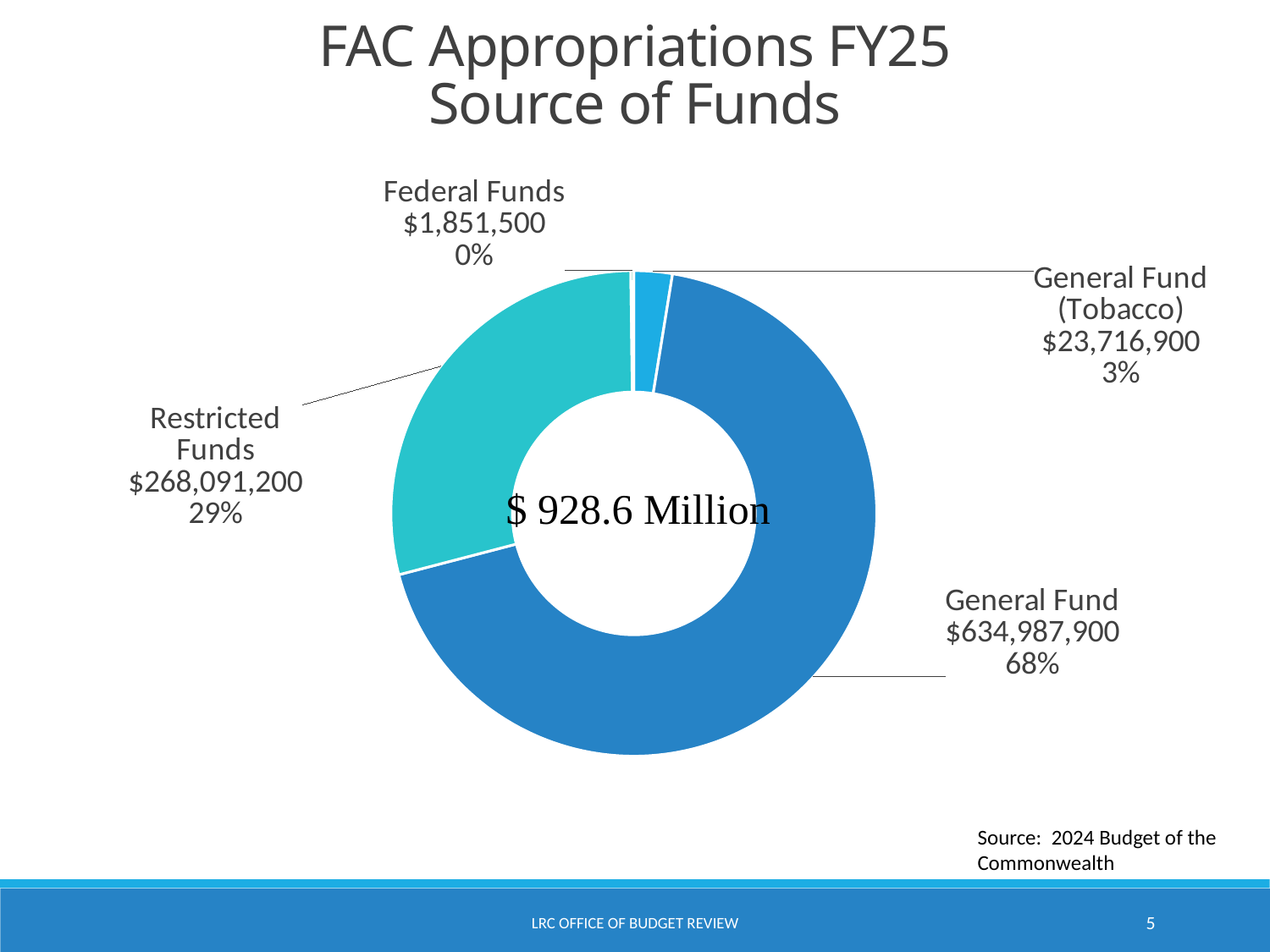
What share of the total does General Fund represent? 68% Which source of funds is the smallest? Federal Funds What kind of chart is shown on the slide? Pie chart (doughnut) What is the value for General Fund (Tobacco)? $23,716,900 Which source of funds is the largest? General Fund What is the value for General Fund? $634,987,900 Which is larger, General Fund (Tobacco) or Federal Funds? General Fund (Tobacco) What is the value for Federal Funds? $1,851,500 How many sources of funds are shown in the chart? 4 What is the value for Restricted Funds? $268,091,200 What share of the total does Restricted Funds represent? 29% What is the difference between General Fund and Restricted Funds? $366,896,700